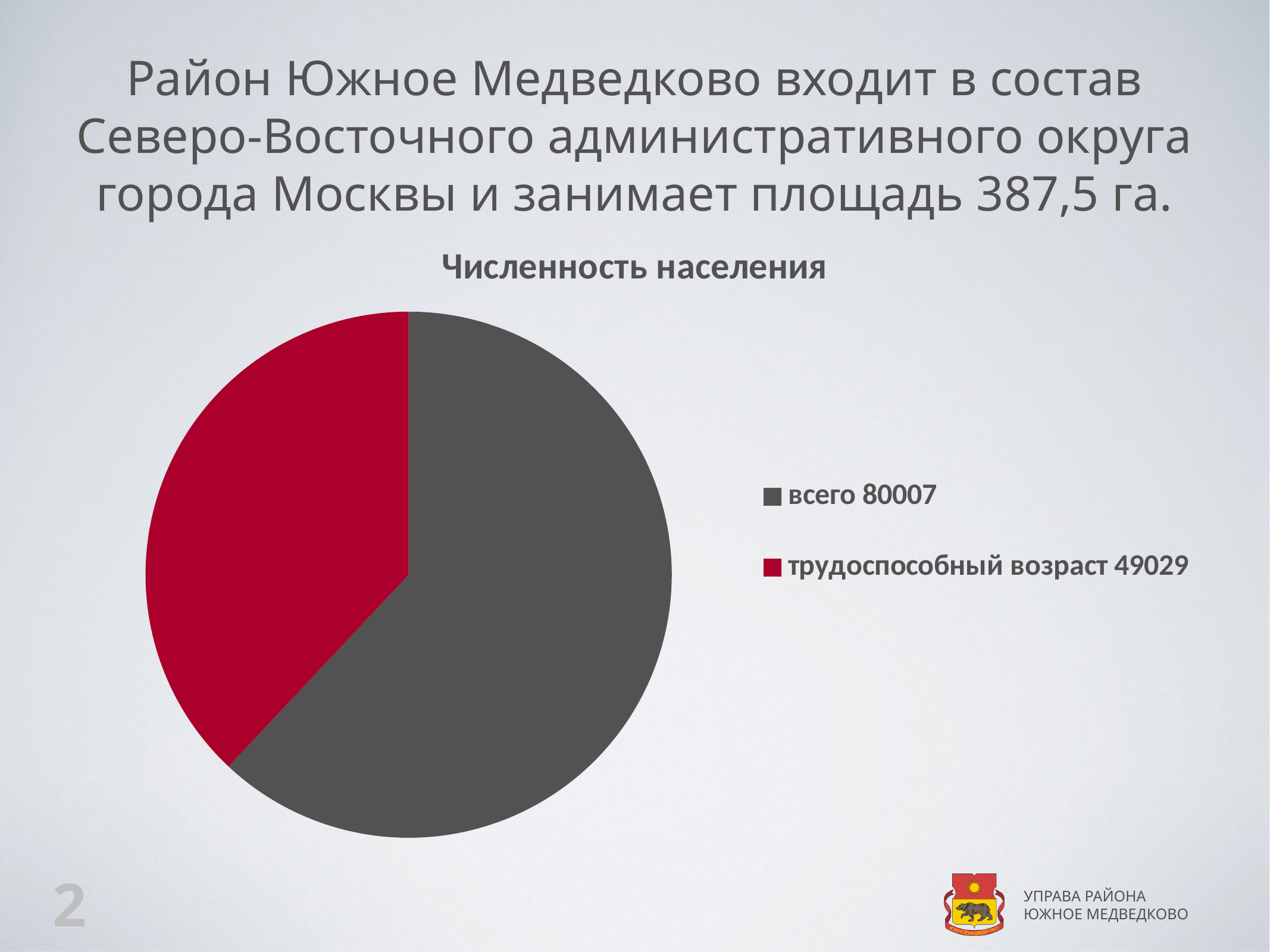
How many entries does the legend list? 2 Which is larger, the value for "всего" or the value for "трудоспособный возраст"? всего What is the title of the chart? Численность населения Which slice is the smallest? трудоспособный возраст 49029 How many slices does the pie chart have? 2 What is the difference between the value for "всего" and the value for "трудоспособный возраст"? 30978 What type of chart is shown on the slide? pie chart What is the sum of the two values shown in the legend? 129036 What colour is the slice for "трудоспособный возраст"? red Which slice is the largest? всего 80007 What value is given for "трудоспособный возраст" in the legend? 49029 What value is given for "всего" in the legend? 80007